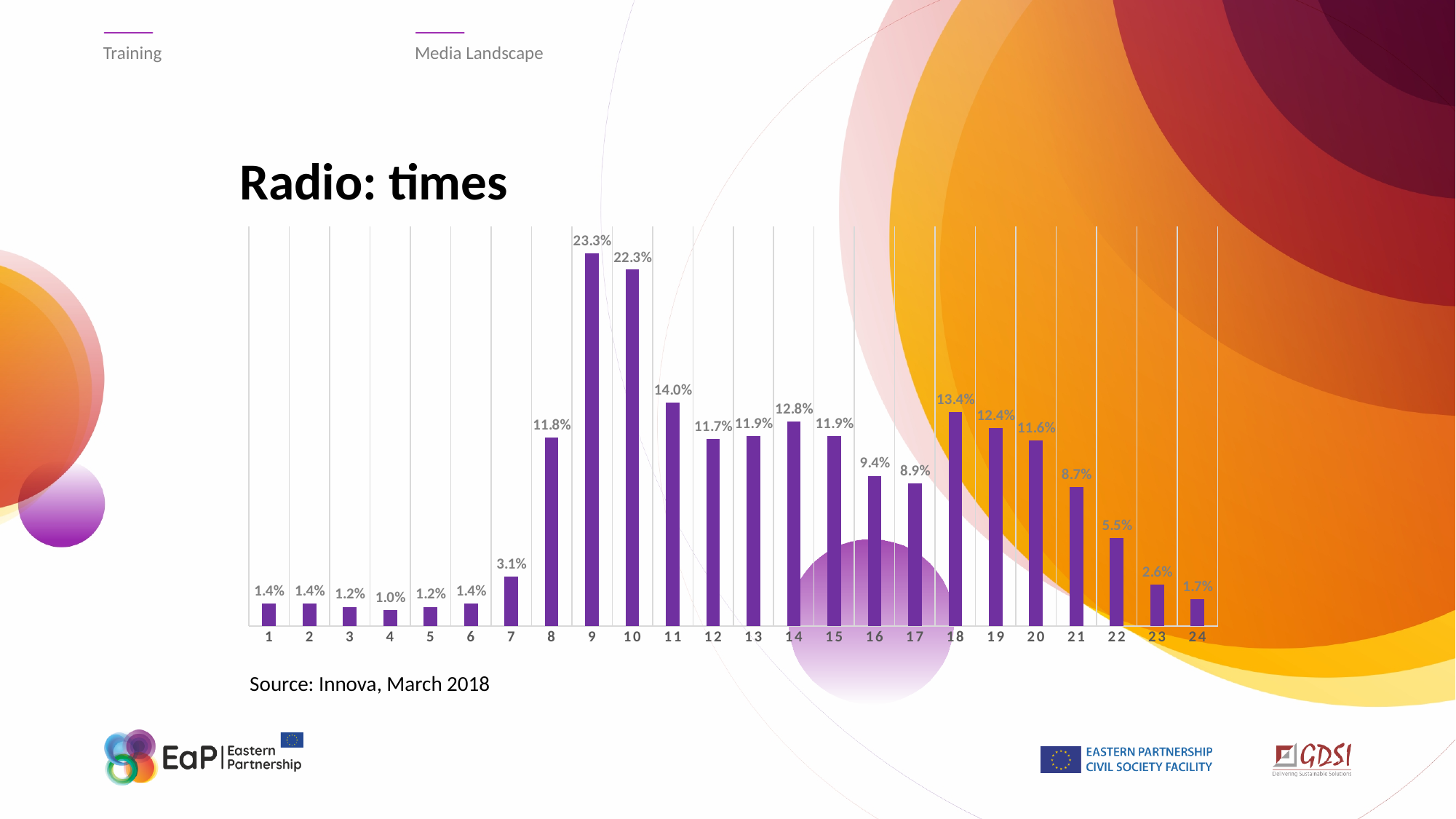
What is the value for category 18? 13.4% How many categories are shown on the x axis? 24 What is the title of the chart? Radio: times What kind of chart is shown? Bar chart Do the values rise or fall from category 18 to category 24? Fall What is the value for category 7? 3.1% What is the value for category 9? 23.3% What is the source given below the chart? Innova, March 2018 What is the difference between the values for category 9 and category 10? 1.0% Which category has the lowest value? 4 Which category has the highest value? 9 Which is larger, the value for category 11 or the value for category 19? 11